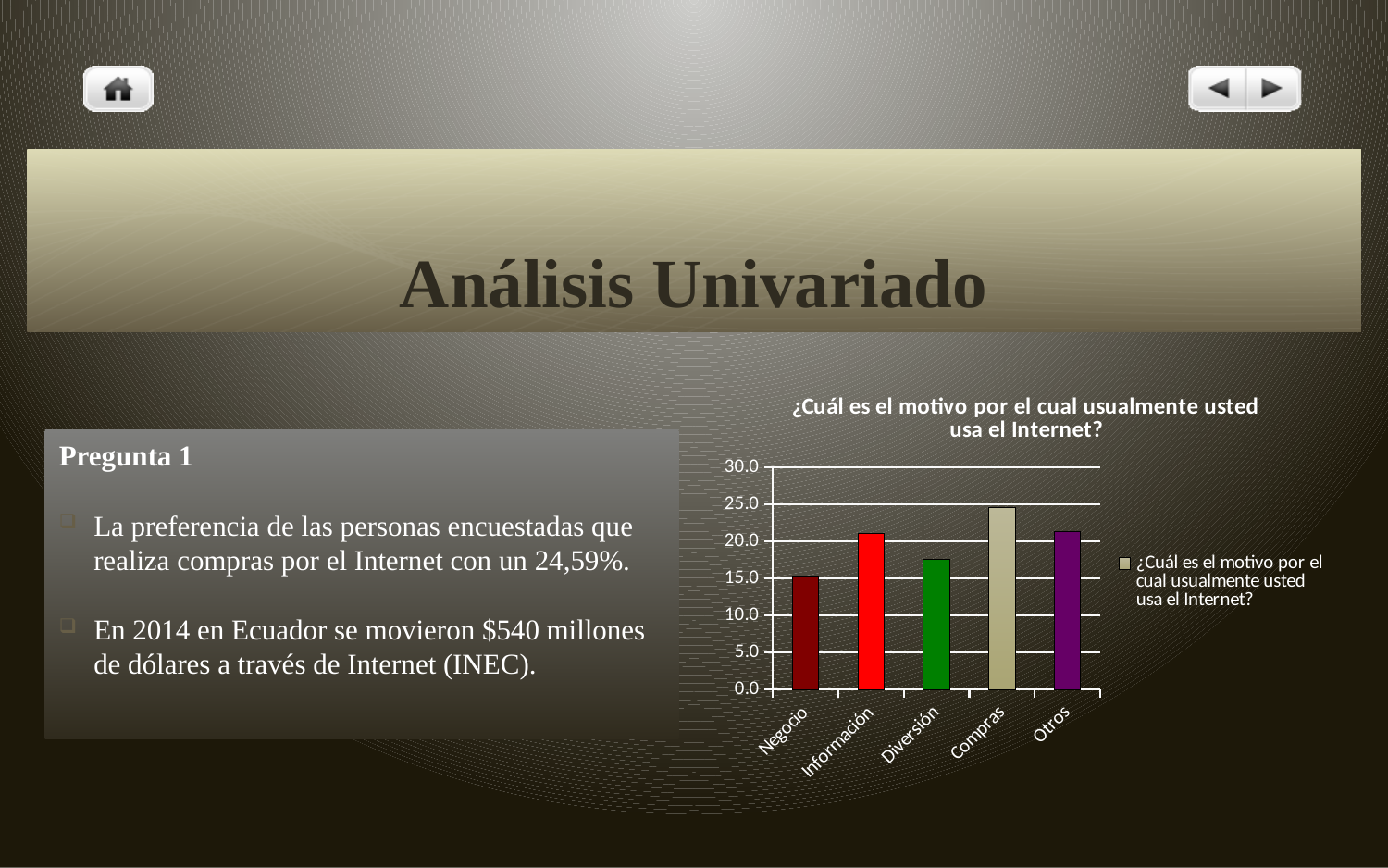
Is the value for Información greater or less than 15.0? greater Which is larger, the value for Negocio or the value for Diversión? Diversión Which is larger, the value for Compras or the value for Diversión? Compras How many series does the chart legend list? 1 Is the value for Compras greater or less than 20.0? greater Is the value for Negocio greater or less than 20.0? less Which category has the lowest bar in the chart? Negocio Which category has the highest bar in the chart? Compras What is the title of the chart? ¿Cuál es el motivo por el cual usualmente usted usa el Internet? How many categories are shown on the x axis of the chart? 5 What type of chart is shown on the slide? bar chart